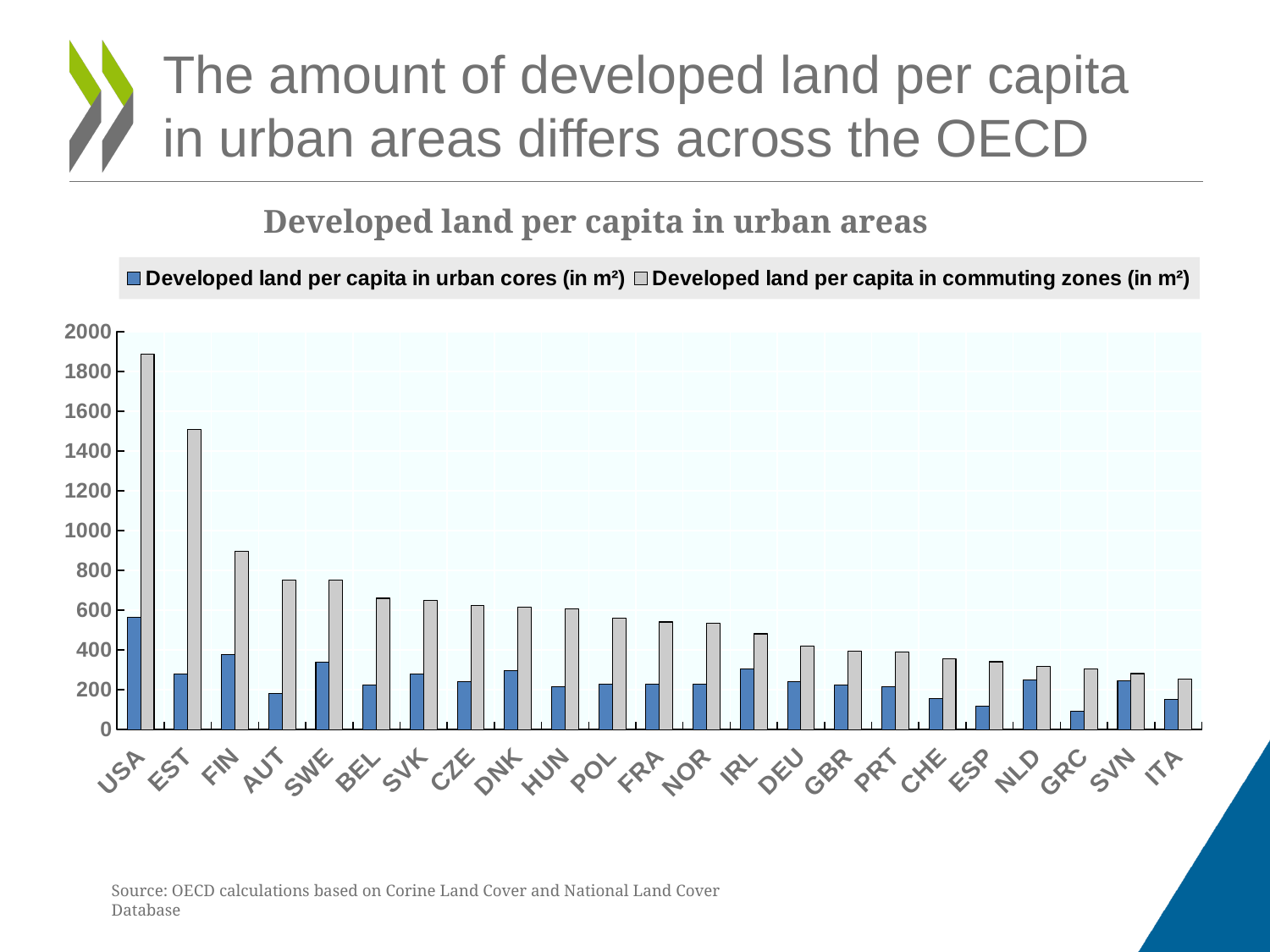
Which country has the highest developed land per capita in commuting zones? USA Which country has the lowest developed land per capita in urban cores? GRC Is the developed land per capita in urban cores for GRC greater or less than 200? less What kind of chart is shown on the slide? bar chart Is the developed land per capita in commuting zones for USA greater or less than 1800? greater Do the developed land per capita in commuting zones values generally rise or fall from left to right across the countries? fall How many series does the legend list? 2 Is the developed land per capita in commuting zones for FIN greater or less than 1000? less Which is larger: developed land per capita in commuting zones for EST or for FIN? EST Which country has the lowest developed land per capita in commuting zones? ITA How many countries are shown on the x axis? 23 Which country has the highest developed land per capita in urban cores? USA